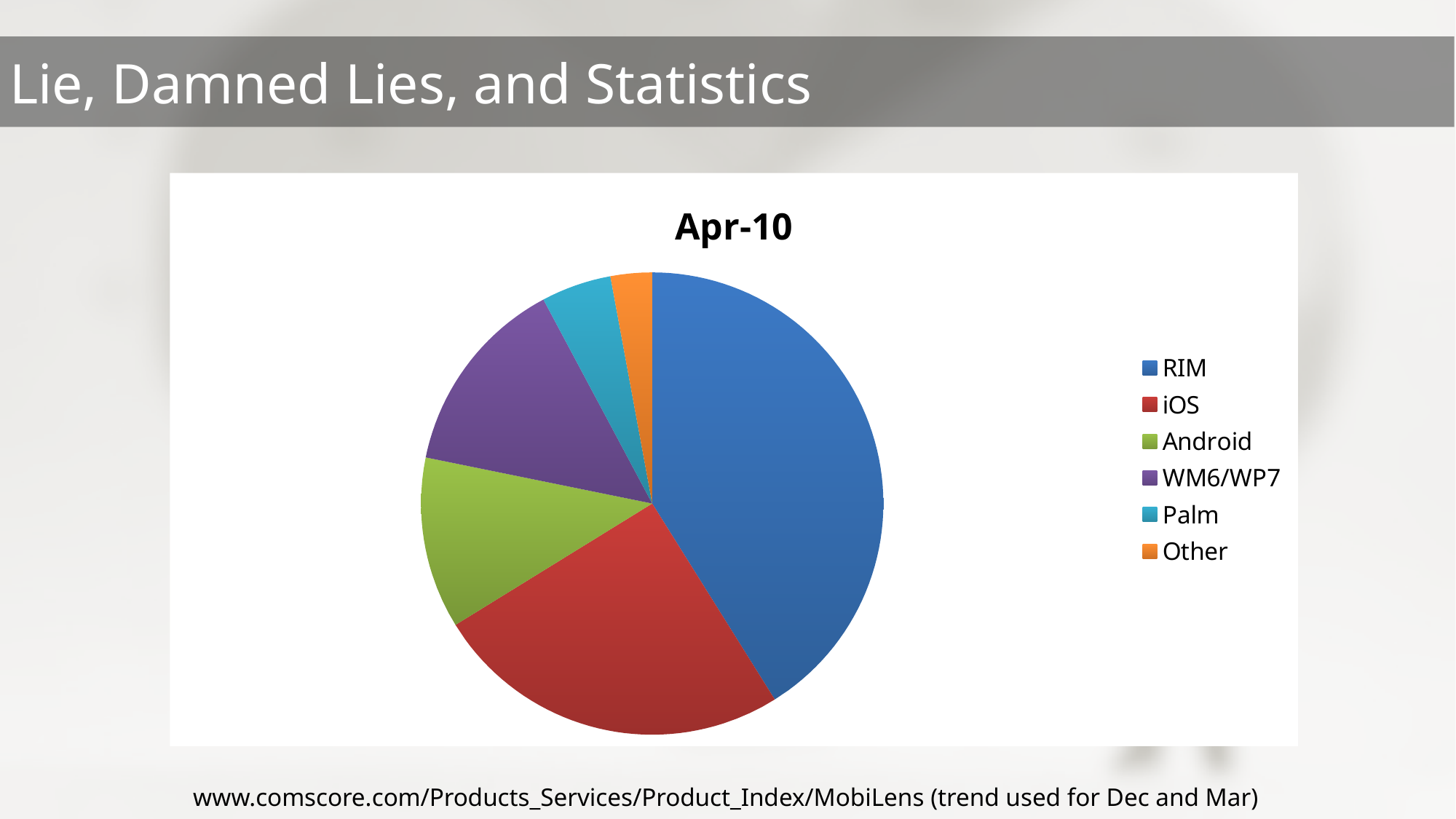
Which slice is larger, Palm or Other? Palm Which slice is larger, RIM or iOS? RIM What is the title of the chart? Apr-10 Which slice is larger, WM6/WP7 or Palm? WM6/WP7 How many entries does the legend list? 6 What kind of chart is shown on the slide? pie chart Which category is shown in blue in the pie chart? RIM Which category has the largest slice of the pie? RIM Which category has the smallest slice of the pie? Other How many slices does the pie chart have? 6